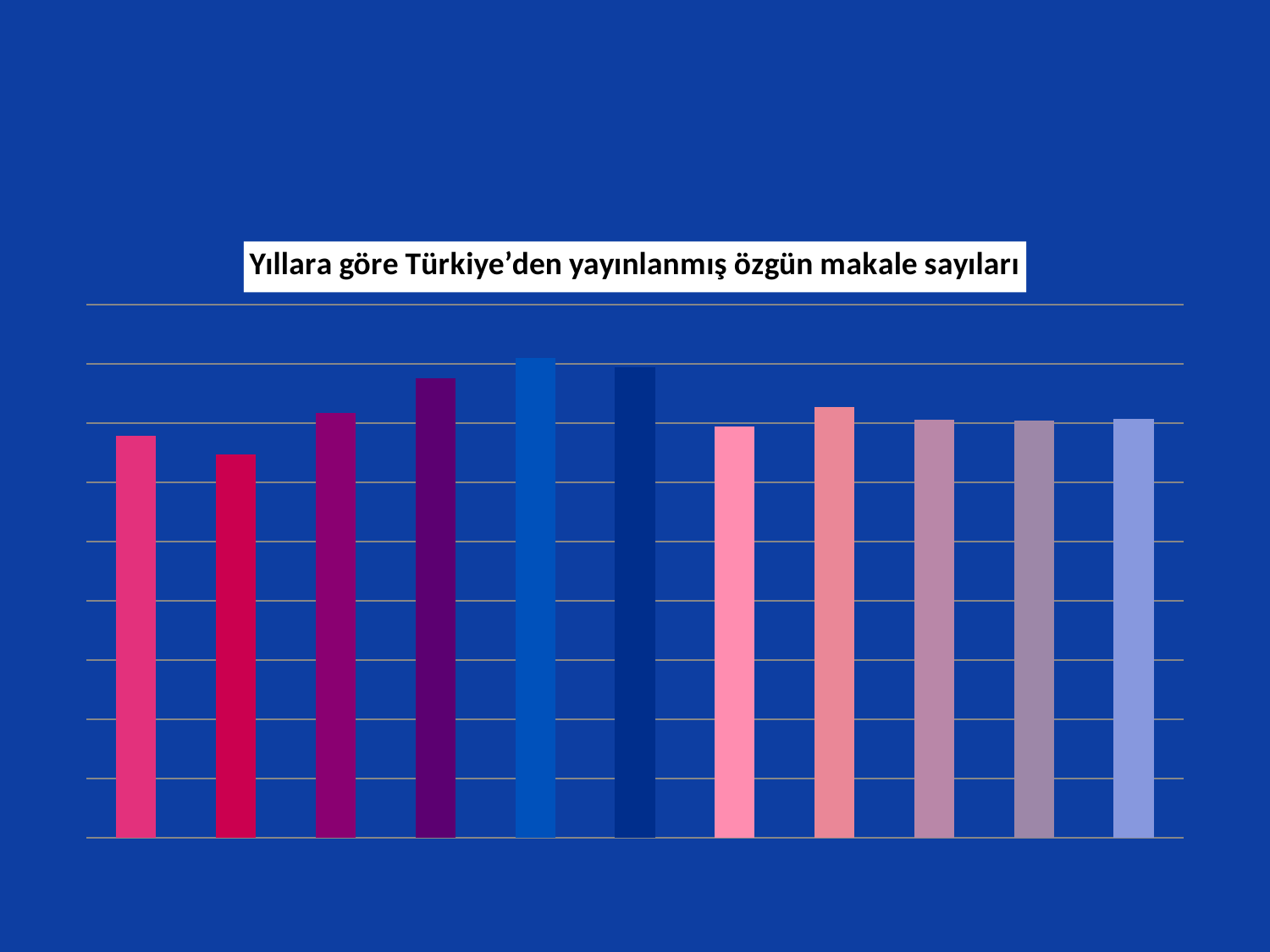
Counting from the left, which bar is the tallest in the chart? the fifth bar How many bars are plotted in the chart? 11 What kind of chart is shown on the slide? bar chart What is the title of the chart? Yıllara göre Türkiye'den yayınlanmış özgün makale sayıları Do the bar heights rise or fall from the second bar to the fifth bar from the left? rise Does the chart display a legend? No Do the bar heights rise or fall from the fifth bar to the seventh bar from the left? fall Which is taller, the first bar from the left or the second bar from the left? the first bar Which is taller, the fifth bar from the left or the sixth bar from the left? the fifth bar Counting from the left, which bar is the shortest in the chart? the second bar